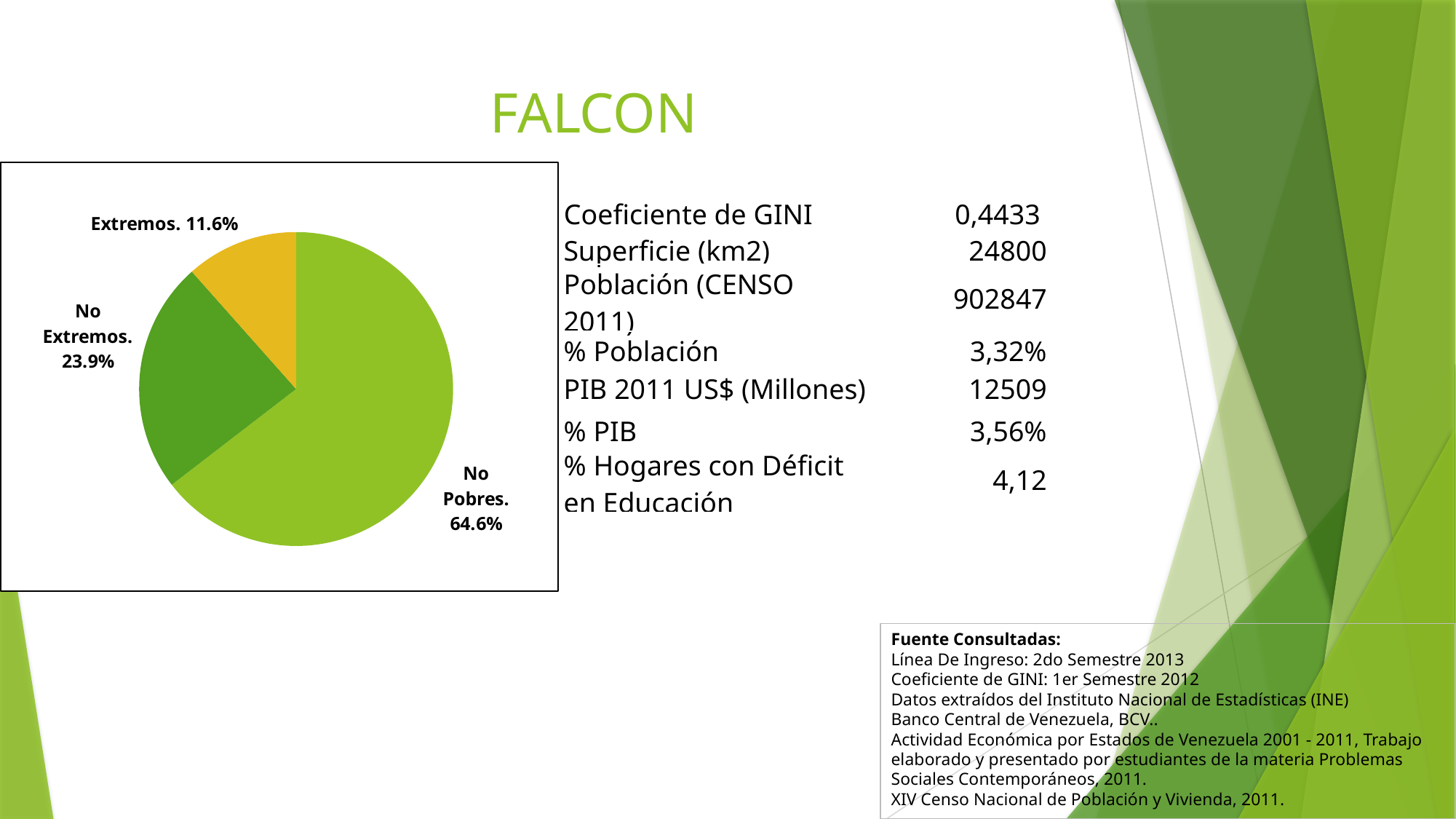
What share of the pie does the 'No Extremos' slice represent? 23.9% What kind of chart is shown on the slide? pie chart What is the difference in percentage points between the 'No Extremos' slice and the 'Extremos' slice? 12.3 Which is larger in the pie chart, 'No Extremos' or 'Extremos'? No Extremos Which slice of the pie chart is the largest? No Pobres Which slice of the pie chart is the smallest? Extremos What share of the pie does the 'No Pobres' slice represent? 64.6% What is the difference in percentage points between the 'No Pobres' slice and the 'No Extremos' slice? 40.7 What share of the pie does the 'Extremos' slice represent? 11.6% What colour is the 'Extremos' slice of the pie chart? yellow What is the title of the slide containing the pie chart? FALCON How many slices does the pie chart have? 3